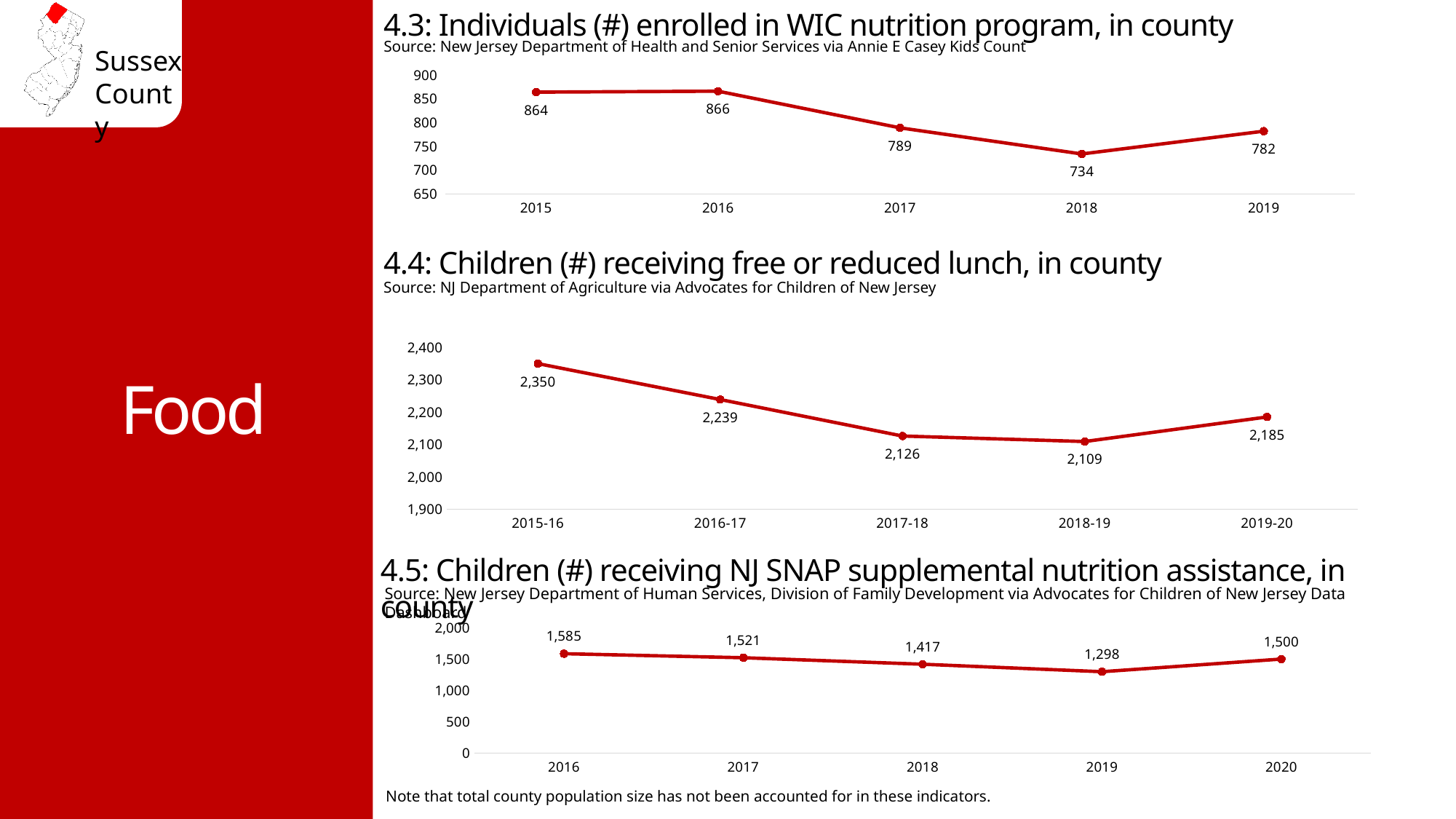
In the chart '4.3: Individuals (#) enrolled in WIC nutrition program, in county', which year has the highest value? 2016 In the chart '4.4: Children (#) receiving free or reduced lunch, in county', what kind of chart is shown? Line chart In the chart '4.4: Children (#) receiving free or reduced lunch, in county', what is the value for 2016-17? 2,239 In the chart '4.5: Children (#) receiving NJ SNAP supplemental nutrition assistance, in county', what is the difference between the 2016 value and the 2020 value? 85 In the chart '4.4: Children (#) receiving free or reduced lunch, in county', is the value for 2015-16 or 2019-20 larger? 2015-16 In the chart '4.3: Individuals (#) enrolled in WIC nutrition program, in county', what is the value for 2018? 734 In the chart '4.5: Children (#) receiving NJ SNAP supplemental nutrition assistance, in county', do the values rise or fall from 2016 to 2019? Fall In the chart '4.3: Individuals (#) enrolled in WIC nutrition program, in county', what is the difference between the 2015 value and the 2019 value? 82 In the chart '4.5: Children (#) receiving NJ SNAP supplemental nutrition assistance, in county', which year has the lowest value? 2019 In the chart '4.5: Children (#) receiving NJ SNAP supplemental nutrition assistance, in county', what is the value for 2017? 1,521 In the chart '4.4: Children (#) receiving free or reduced lunch, in county', which school year has the lowest value? 2018-19 In the chart '4.3: Individuals (#) enrolled in WIC nutrition program, in county', how many data points are plotted? 5